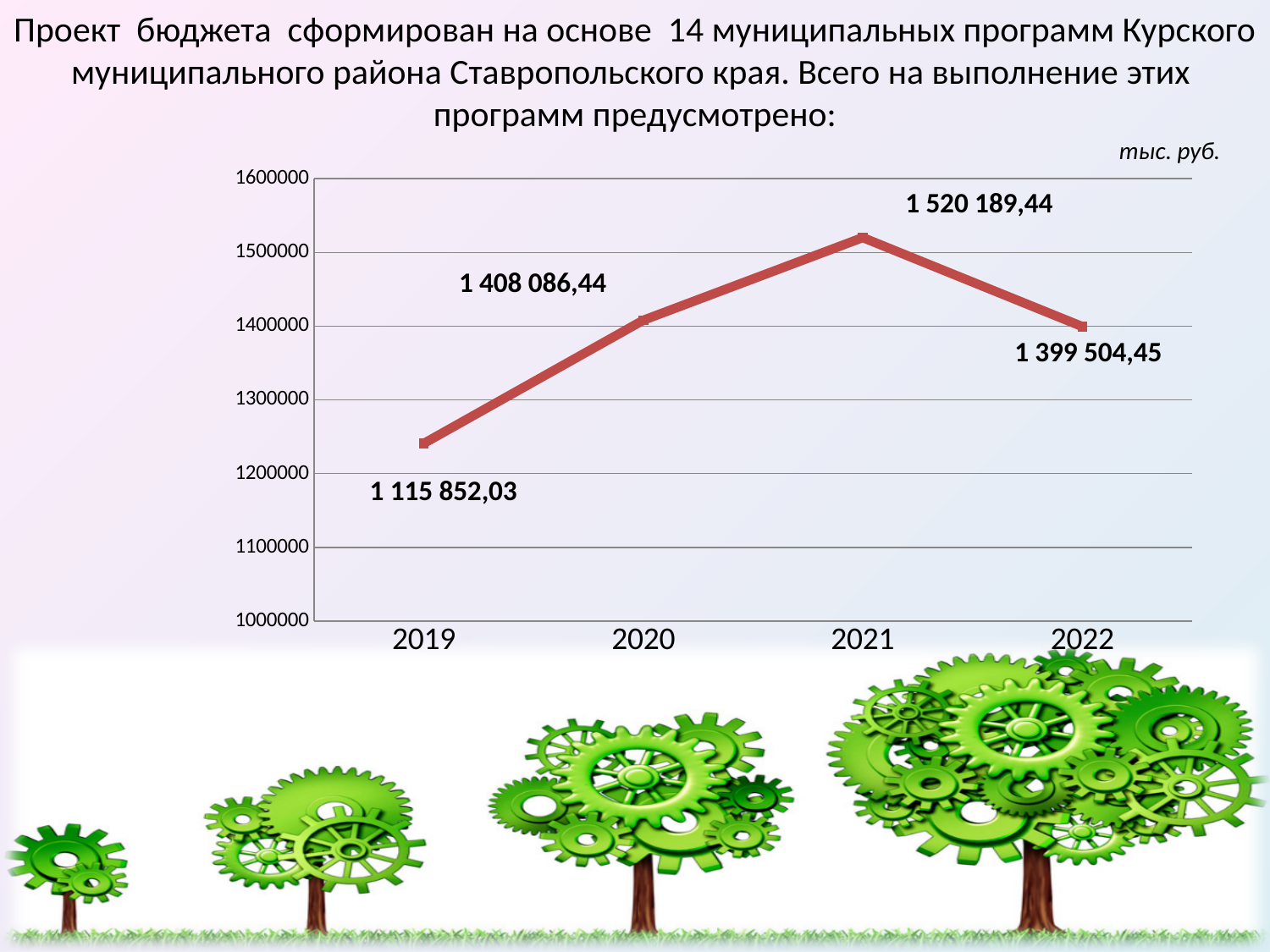
Is the value for 2021 greater or less than 1500000? greater What is the difference between the values for 2021 and 2022? 120 684,99 What is the difference between the values for 2021 and 2020? 112 103,00 What value is shown for 2021? 1 520 189,44 What value is shown for 2019? 1 115 852,03 How many years are plotted on the chart? 4 What kind of chart is shown on the slide? line chart What value is shown for 2020? 1 408 086,44 What value is shown for 2022? 1 399 504,45 Which year has the lowest value? 2019 Which year has the highest value? 2021 Which is larger, the value for 2020 or the value for 2022? 2020